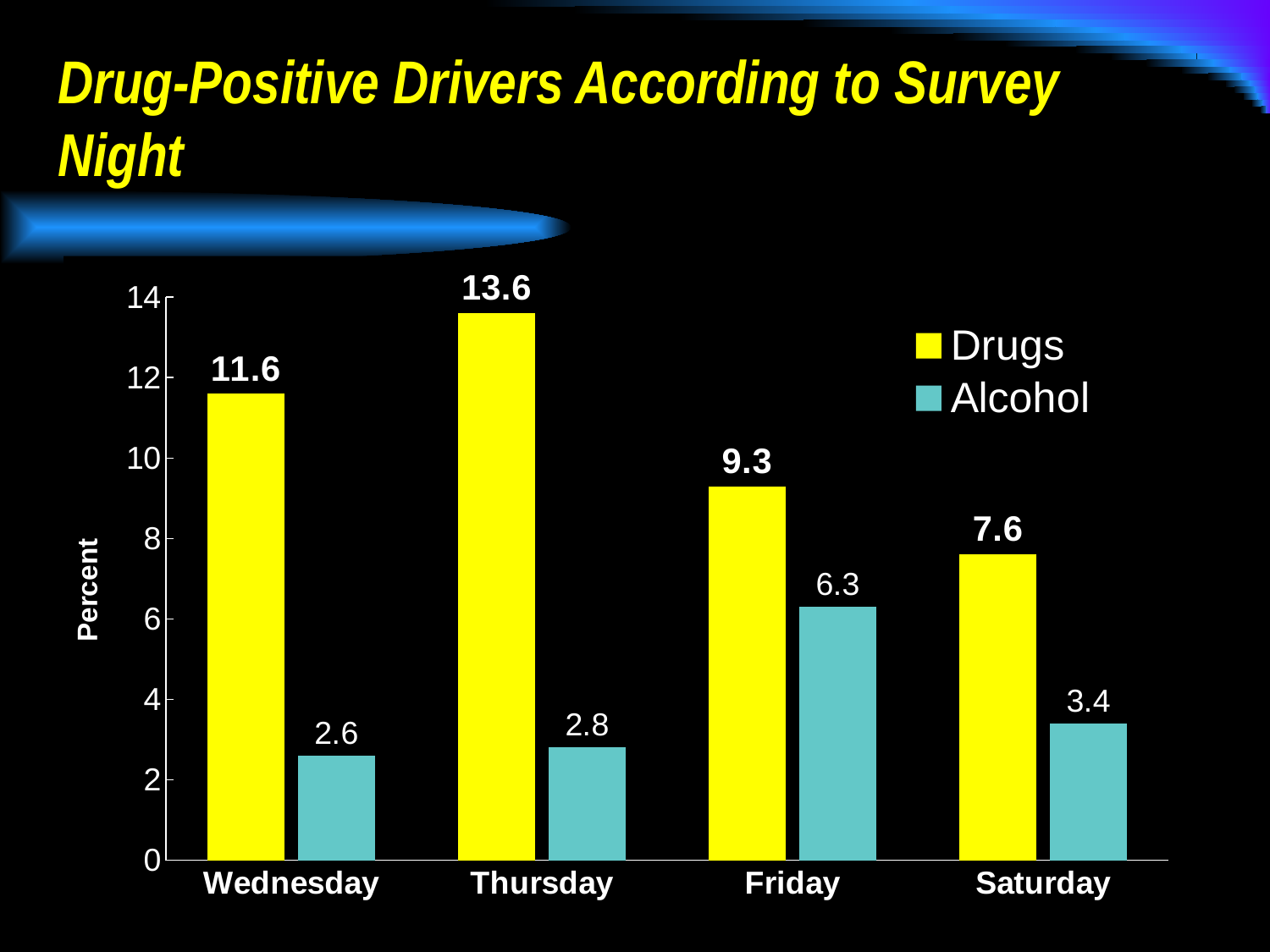
What is the difference between the Drugs and Alcohol values for Wednesday? 9.0 How many survey nights are shown on the x axis? 4 Which is larger, the Alcohol value for Friday or the Alcohol value for Saturday? Friday Which night has the lowest Alcohol value? Wednesday What is the label on the vertical axis? Percent What is the Drugs value for Thursday? 13.6 How many series does the legend list? 2 What is the Drugs value for Saturday? 7.6 Is the Drugs value for Friday greater or less than 8? greater What kind of chart is shown on the slide? bar chart Which night has the highest Drugs value? Thursday What is the Alcohol value for Friday? 6.3